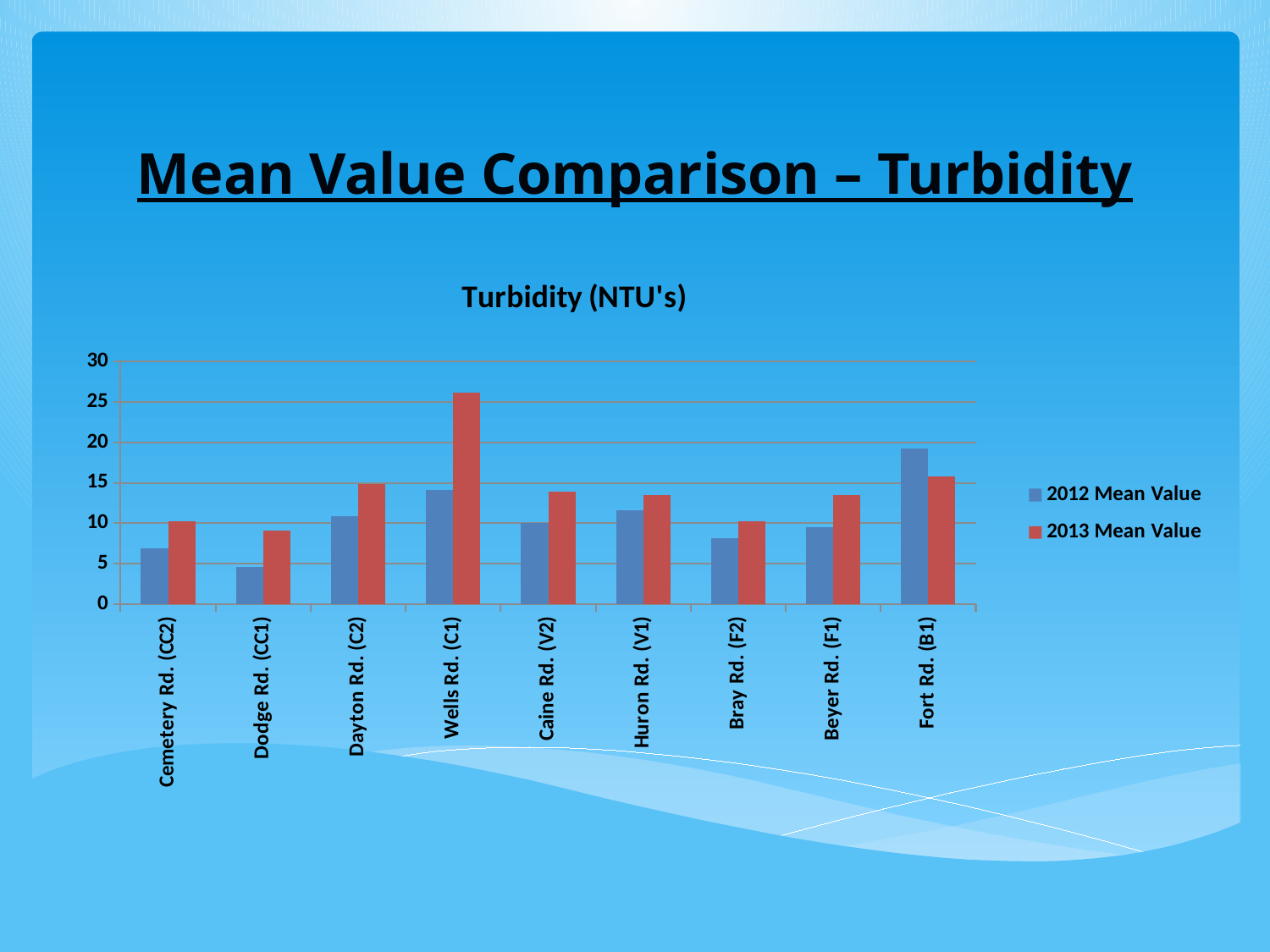
Which site has the highest 2012 Mean Value? Fort Rd. (B1) Is the 2013 Mean Value for Wells Rd. (C1) greater or less than 25? greater Which site has the lowest 2012 Mean Value? Dodge Rd. (CC1) Is the 2012 Mean Value for Dodge Rd. (CC1) greater or less than 5? less What kind of chart is shown on the slide? bar chart Is the 2012 Mean Value for Fort Rd. (B1) greater or less than 20? less At Fort Rd. (B1), which is larger: the 2012 Mean Value or the 2013 Mean Value? 2012 Mean Value Which site has the highest 2013 Mean Value? Wells Rd. (C1) At Wells Rd. (C1), which is larger: the 2012 Mean Value or the 2013 Mean Value? 2013 Mean Value What is the title printed above the chart? Turbidity (NTU's) How many sites (categories) are shown on the x axis? 9 How many series does the legend list? 2